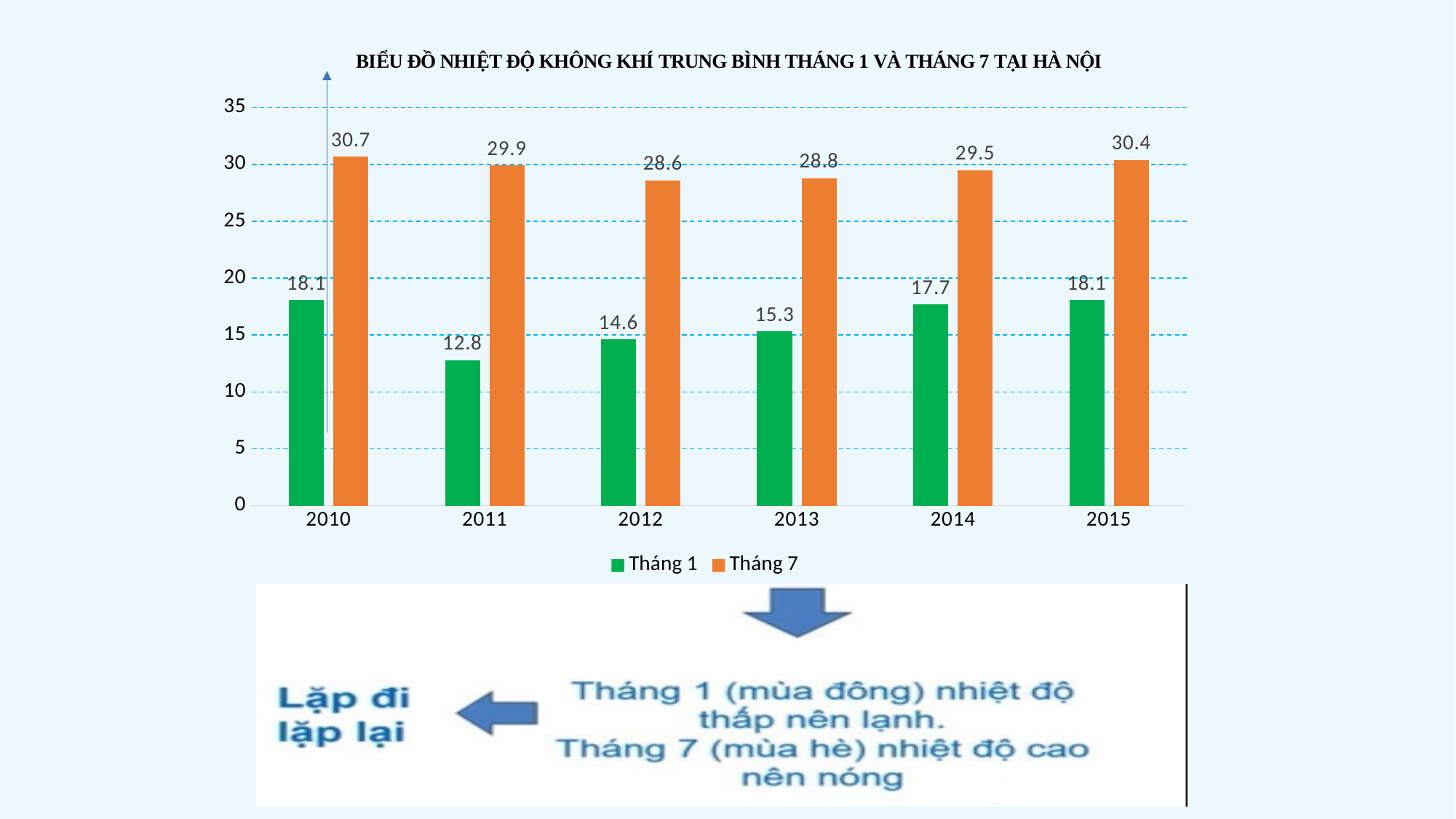
Which is larger, the Tháng 1 value in 2014 or the Tháng 1 value in 2015? 2015 Which year has the highest Tháng 7 value? 2010 What is the value for Tháng 7 in 2010? 30.7 What is the value for Tháng 1 in 2013? 15.3 What is the value for Tháng 1 in 2011? 12.8 How many series does the legend list? 2 Is the value for Tháng 7 in 2013 greater or less than 25? greater Which year has the lowest Tháng 1 value? 2011 What kind of chart is shown on the slide? bar chart Which colour represents Tháng 7 in the chart? orange What is the difference between the Tháng 7 and Tháng 1 values in 2012? 14 How many years are shown on the x axis? 6